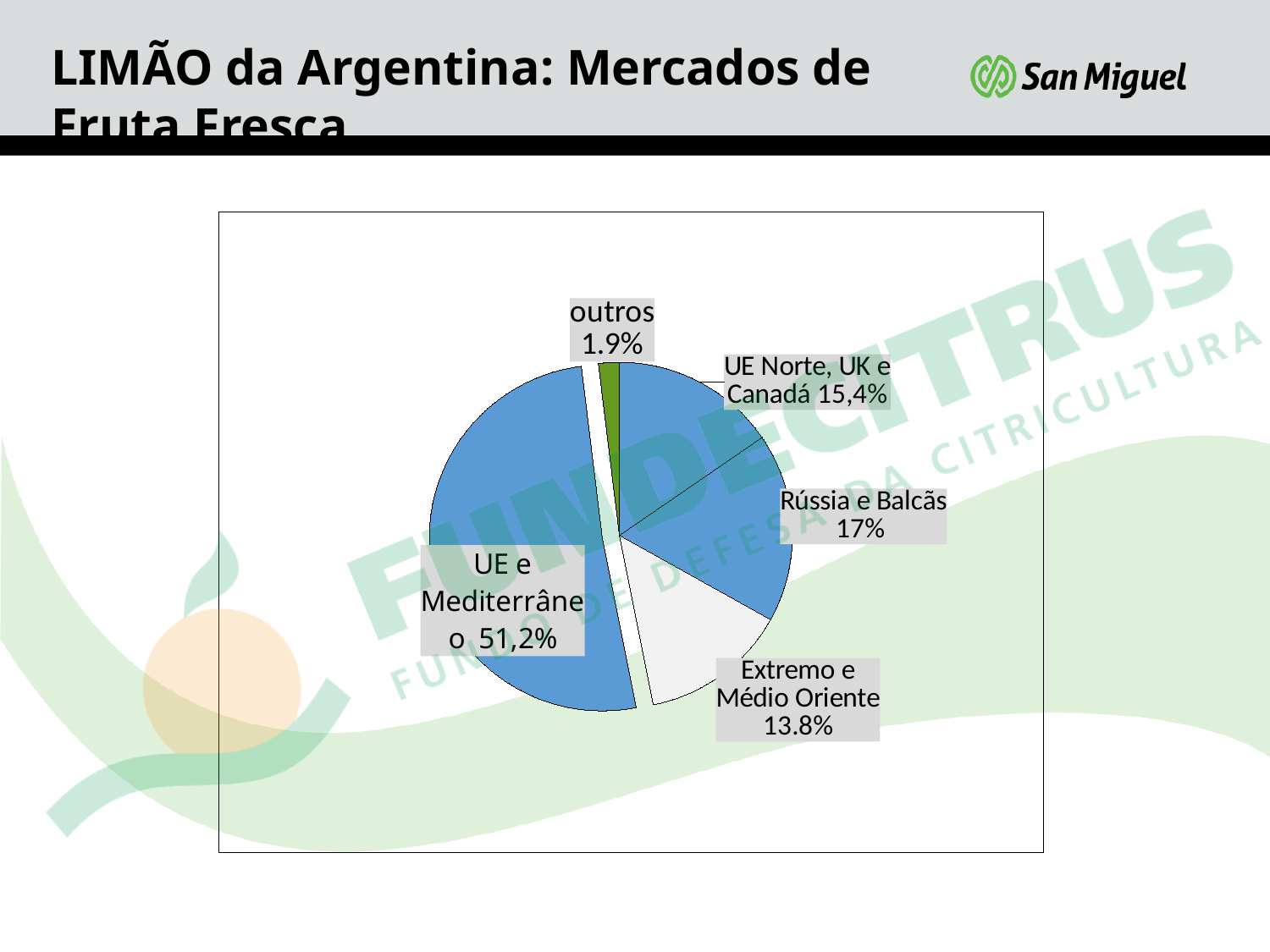
How many slices does the pie chart have? 5 What kind of chart is shown on the slide? pie chart What share of the pie does UE e Mediterrâneo hold? 51,2% What is the value shown for the outros slice? 1.9% What is the value shown for Extremo e Médio Oriente? 13.8% Which market has the smallest slice of the pie? outros What is the value shown for Rússia e Balcãs? 17% Which is larger, Rússia e Balcãs or Extremo e Médio Oriente? Rússia e Balcãs What is the value shown for UE Norte, UK e Canadá? 15,4% Which market has the largest slice of the pie? UE e Mediterrâneo What is the title of the slide containing the pie chart? LIMÃO da Argentina: Mercados de Fruta Fresca